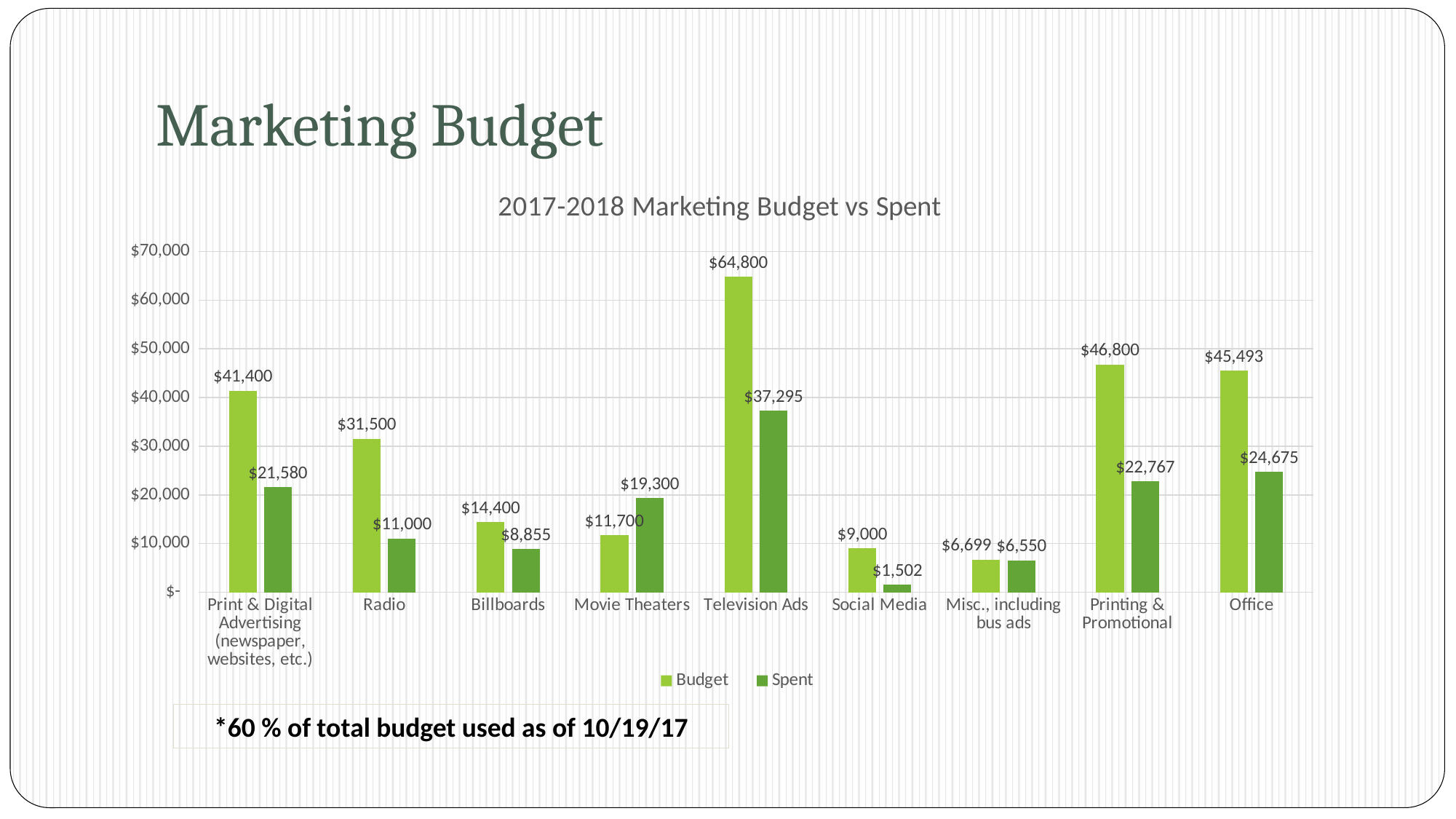
Which is larger for Movie Theaters, the Budget value or the Spent value? Spent What is the title of the chart? 2017-2018 Marketing Budget vs Spent What is the difference between the Budget and Spent values for Television Ads? $27,505 What is the Spent value for Social Media? $1,502 Which category has the lowest Spent value? Social Media Which category has the highest Budget value? Television Ads How many series does the legend list? 2 What is the Budget value for Television Ads? $64,800 How many categories are shown on the x axis? 9 What kind of chart is shown on the slide? Bar chart Is the Budget value for Office greater or less than $40,000? greater What is the Spent value for Radio? $11,000